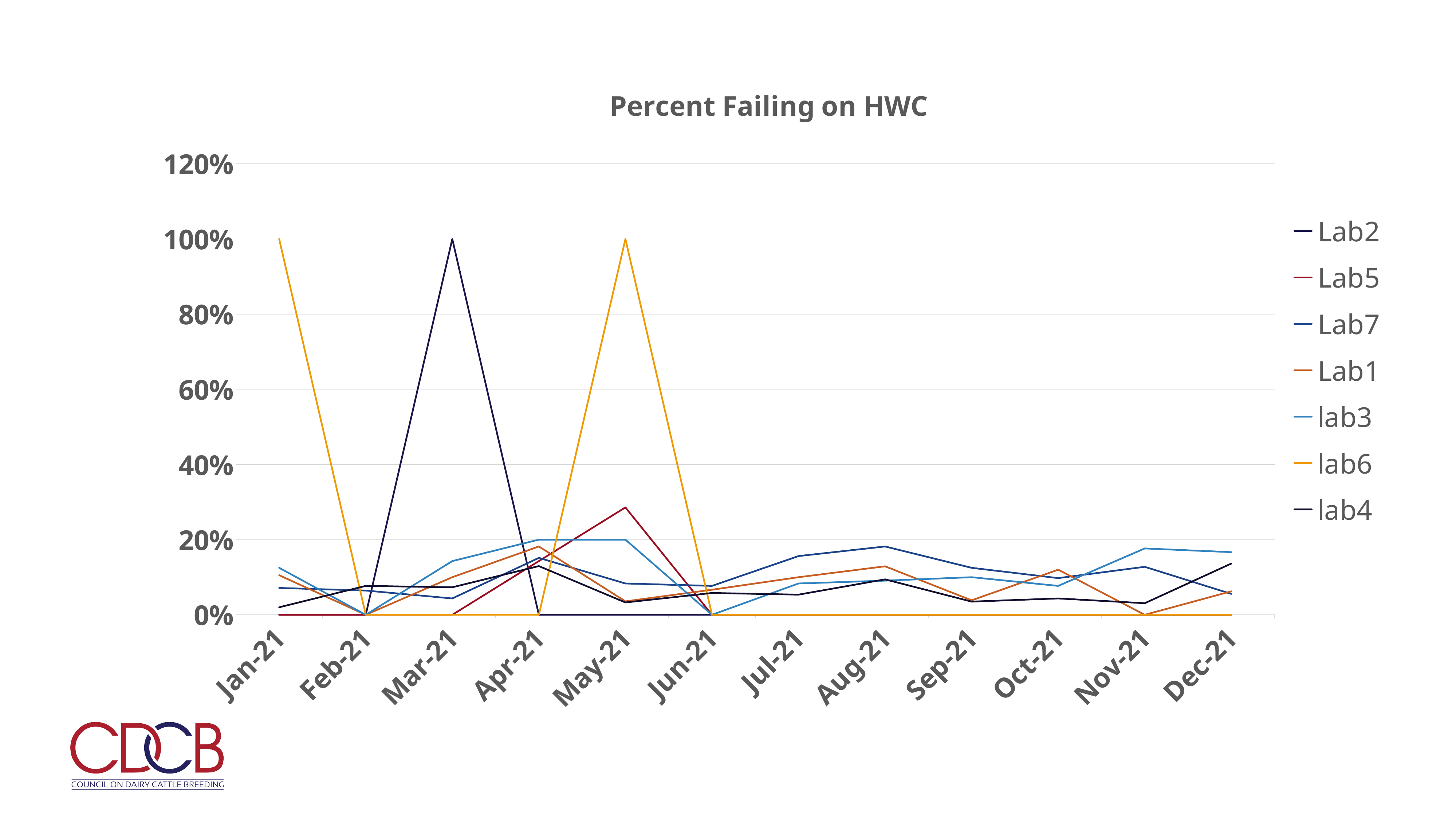
What is the value for lab6 in May-21? 100% In May-21, which is larger, the value for lab6 or the value for Lab5? lab6 How many series does the legend list? 7 What kind of chart is shown on the slide? line chart Does the value for lab6 rise or fall from Jan-21 to Feb-21? fall What is the value for Lab2 in Mar-21? 100% Is the value for Lab5 in May-21 greater or less than 20%? greater What is the title of the chart? Percent Failing on HWC How many months are shown along the x axis? 12 Which series has the highest value in Mar-21? Lab2 What is the value for lab6 in Feb-21? 0% What is the value for lab6 in Jan-21? 100%